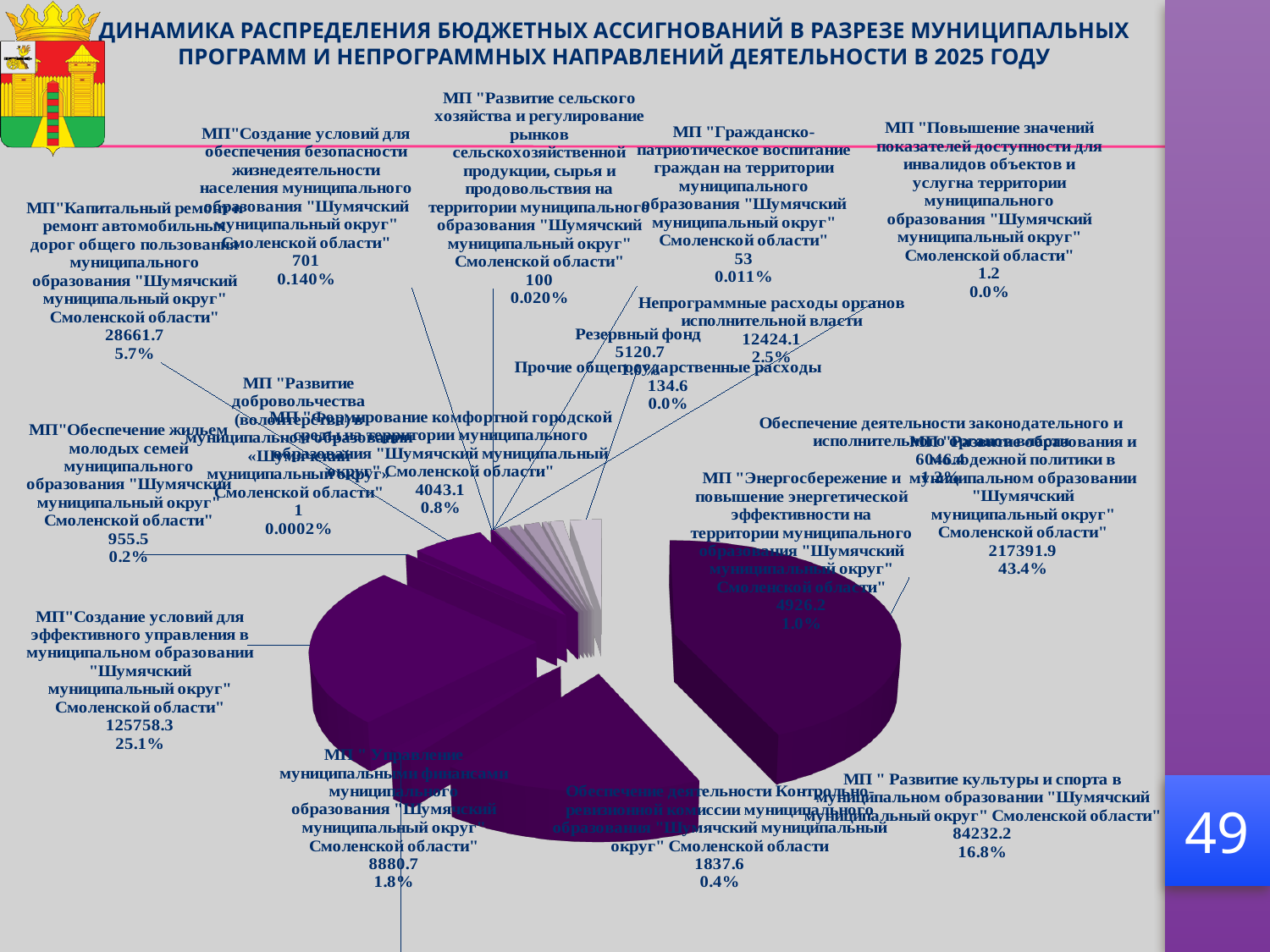
Which category has the smallest value on the chart? МП "Развитие добровольчества (волонтерства)" What is the value shown for the programme "Создание условий для эффективного управления в муниципальном образовании"? 125758.3 What share is shown for the programme "Гражданско-патриотическое воспитание граждан"? 0.011% What is the value shown for "Резервный фонд"? 5120.7 Which is larger: the value for "Капитальный ремонт и ремонт автомобильных дорог" or the value for "Управление муниципальными финансами"? Капитальный ремонт и ремонт автомобильных дорог What share is shown for "Непрограммные расходы органов исполнительной власти"? 2.5% What is the value shown for the programme "Развитие культуры и спорта"? 84232.2 What is the difference between the values for "Развитие образования и молодежной политики" (217391.9) and "Создание условий для эффективного управления" (125758.3)? 91633.6 What share of the budget goes to the programme "Развитие образования и молодежной политики"? 43.4% What is the value shown for "Обеспечение деятельности Контрольно-ревизионной комиссии"? 1837.6 Which category has the largest share of the pie? МП "Развитие образования и молодежной политики" What kind of chart is shown on the slide? pie chart